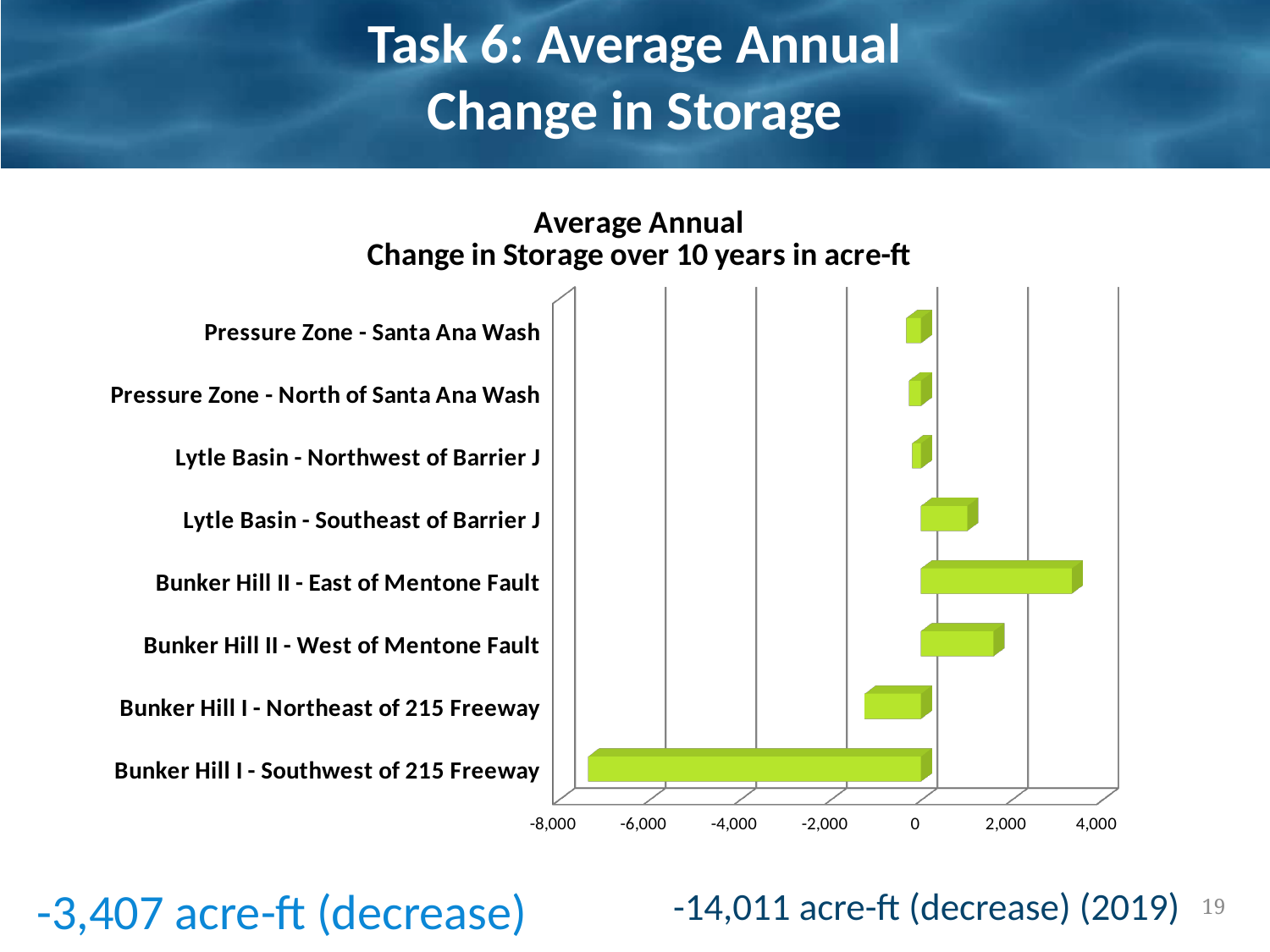
Is the value for Bunker Hill II - West of Mentone Fault greater or less than 2,000? less How many categories (basin areas) are plotted in the chart? 8 Which category has the highest average annual change in storage? Bunker Hill II - East of Mentone Fault What is the title of the chart? Average Annual Change in Storage over 10 years in acre-ft Is the value for Bunker Hill II - East of Mentone Fault greater or less than 2,000? greater What is the lowest value shown on the horizontal axis of the chart? -8,000 Is the value for Bunker Hill I - Southwest of 215 Freeway greater or less than -6,000? less Which is larger, the value for Bunker Hill II - East of Mentone Fault or the value for Lytle Basin - Southeast of Barrier J? Bunker Hill II - East of Mentone Fault Which is larger, the value for Bunker Hill I - Northeast of 215 Freeway or the value for Bunker Hill I - Southwest of 215 Freeway? Bunker Hill I - Northeast of 215 Freeway What kind of chart is shown on the slide? Bar chart Which category has the lowest average annual change in storage? Bunker Hill I - Southwest of 215 Freeway